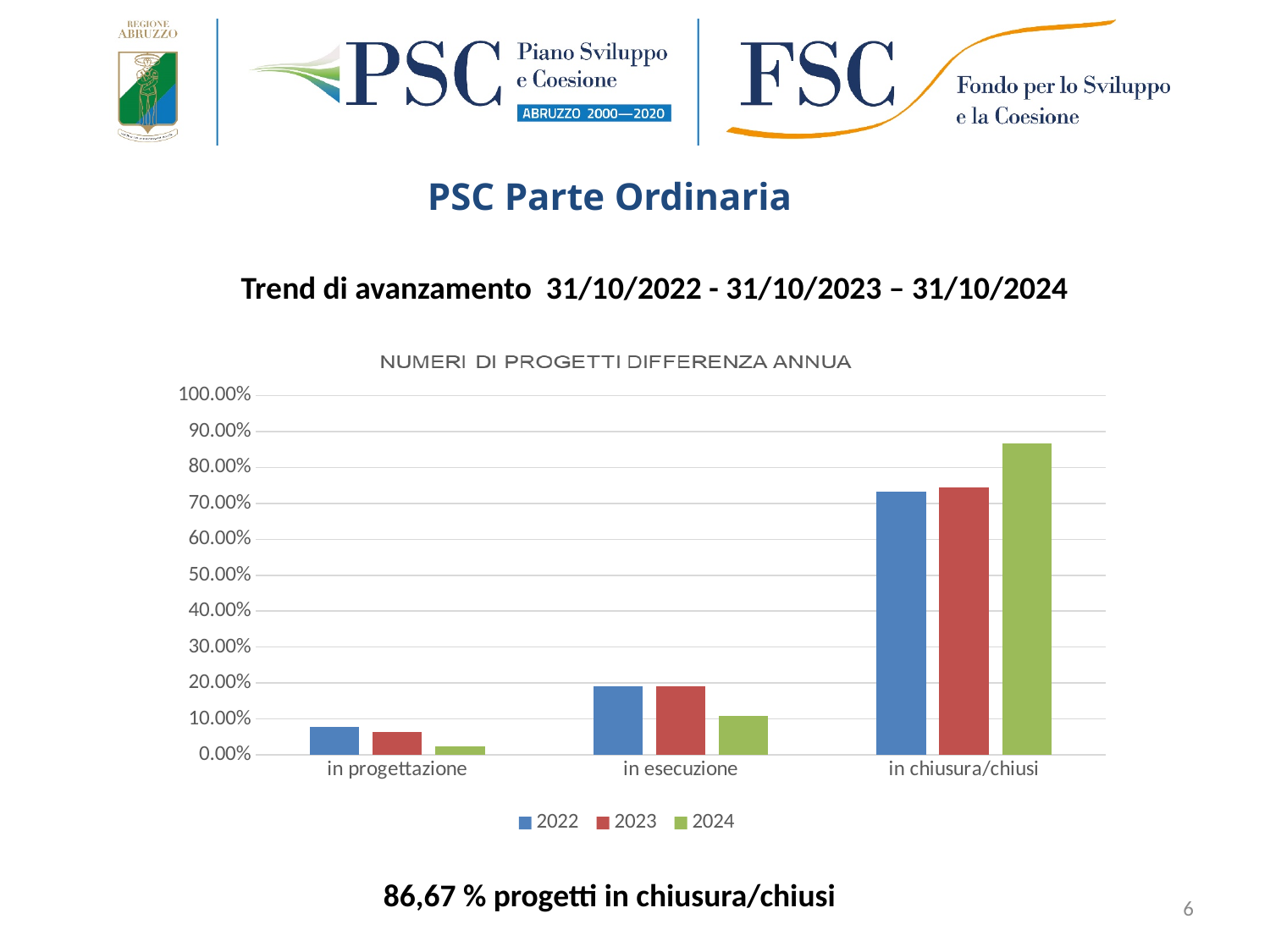
What is the title of the chart? NUMERI DI PROGETTI DIFFERENZA ANNUA Is the 2024 value for in chiusura/chiusi greater or less than 80.00%? greater Which category has the highest values for all three years? in chiusura/chiusi Which category has the lowest value for 2024? in progettazione How many series does the legend list? 3 Is the 2022 value for in progettazione greater or less than 10.00%? less Which is larger for in chiusura/chiusi, the 2022 value or the 2024 value? 2024 Which is larger for in progettazione, the 2022 value or the 2024 value? 2022 Is the 2022 value for in chiusura/chiusi greater or less than 70.00%? greater What kind of chart is shown on the slide? bar chart Do the values for in chiusura/chiusi rise or fall from 2022 to 2024? rise How many categories are shown on the x axis? 3